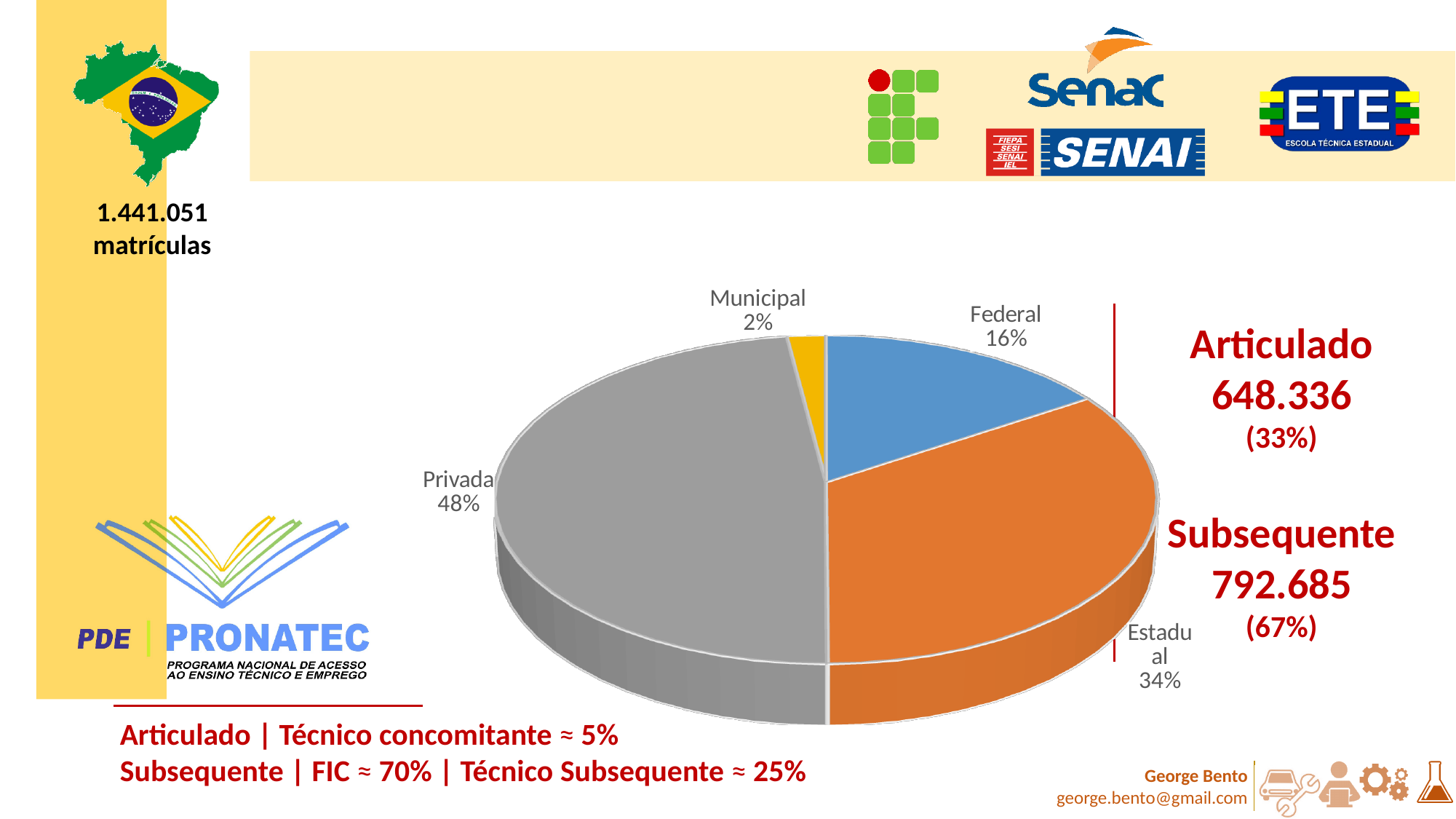
What is the difference in percentage points between Privada and Estadual? 14% Which slice of the pie is the smallest? Municipal What share of the pie does Municipal hold? 2% Which is larger, Federal or Estadual? Estadual What kind of chart is shown on the slide? pie chart How many slices does the pie chart have? 4 What share of the pie does Federal hold? 16% What colour is the Privada slice of the pie? grey What is the combined share of Federal and Municipal? 18% Which slice of the pie is the largest? Privada What share of the pie does Privada hold? 48%